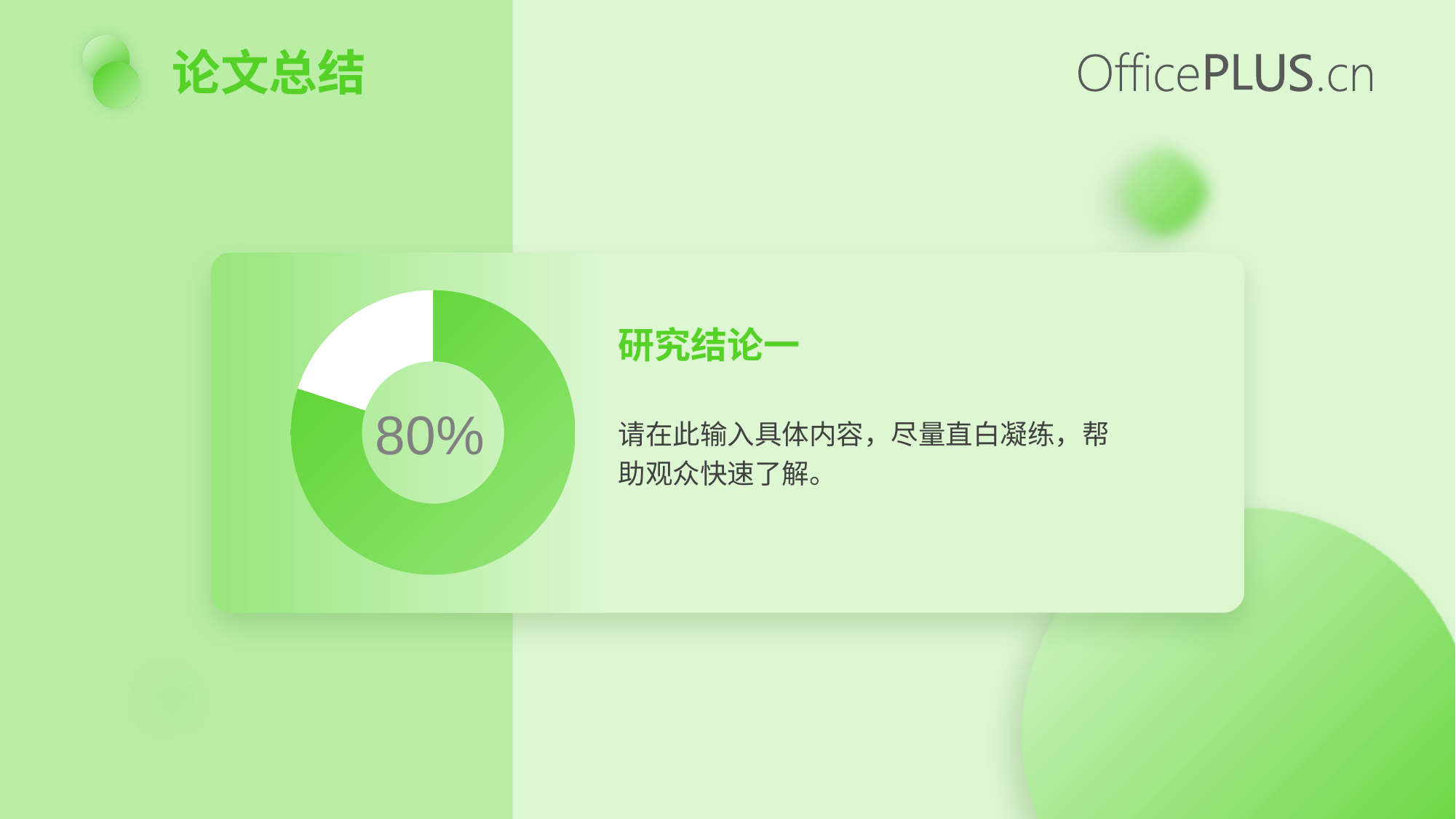
How many segments does the donut chart have? 2 What colour is the larger segment of the donut chart? green What kind of chart is shown on the slide? donut chart Which segment of the donut chart is larger, the green one or the white one? green What share of the donut chart does the white segment represent? 20% What share of the donut chart does the green segment represent? 80% What is the heading printed to the right of the donut chart? 研究结论一 What percentage is printed in the centre of the donut chart? 80% Is the value shown in the donut chart greater or less than 50%? greater What is the difference between the green segment's share and the white segment's share in the donut chart? 60%